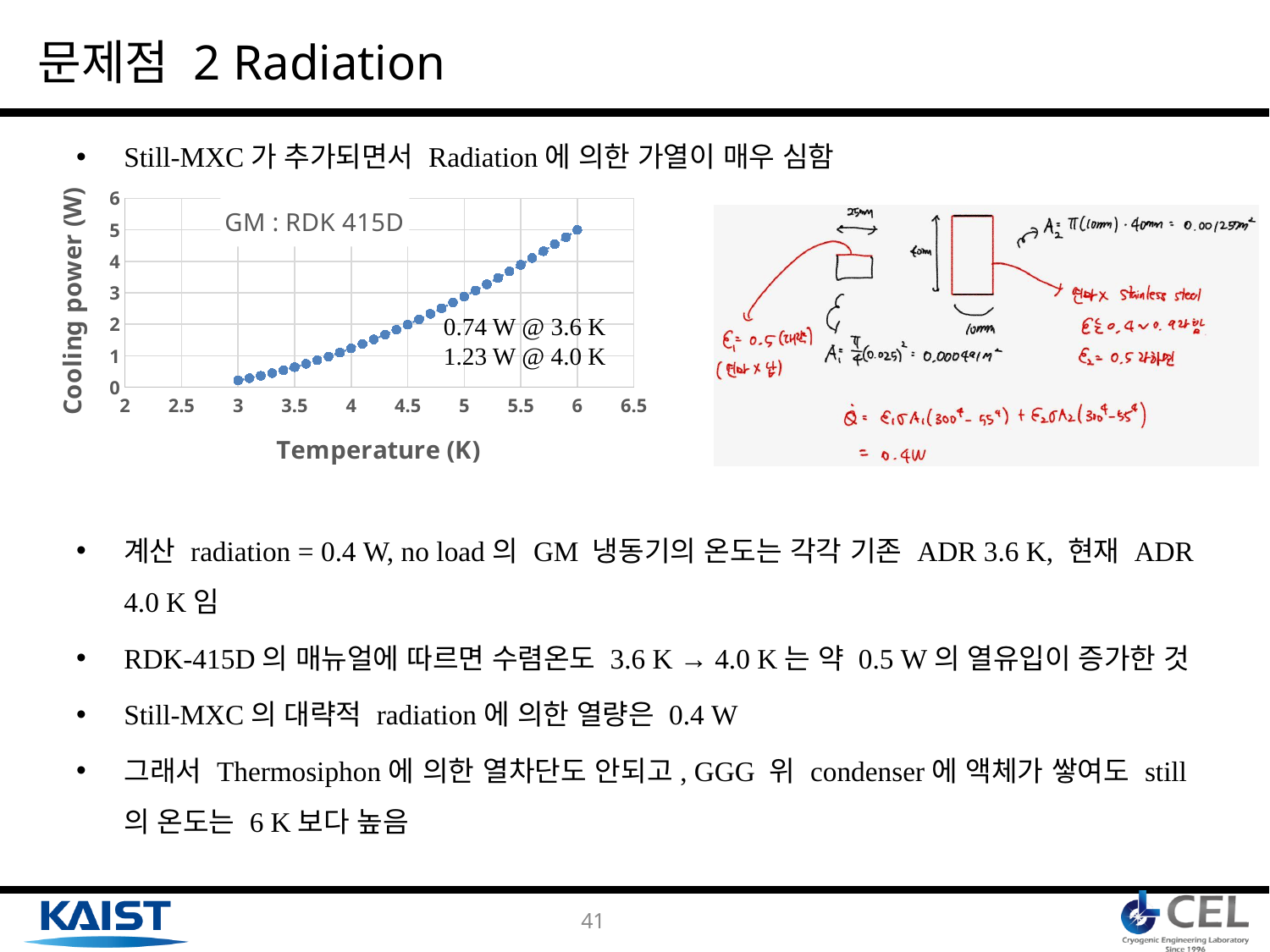
What is the difference between the cooling power at 4.0 K and at 3.6 K? 0.49 W Is the cooling power at 5.5 K greater or less than 3 W? greater According to the chart annotation, what is the cooling power at 3.6 K? 0.74 W Which temperature has the larger cooling power, 3.6 K or 4.0 K? 4.0 K What kind of chart is shown on the slide? scatter chart According to the chart annotation, what is the cooling power at 4.0 K? 1.23 W What is the label of the y axis of the chart? Cooling power (W) Is the cooling power at 3 K greater or less than 1 W? less Is the cooling power at 5 K greater or less than 2 W? greater Does the cooling power rise or fall as temperature increases along the x axis? rise What is the title of the chart? GM : RDK 415D